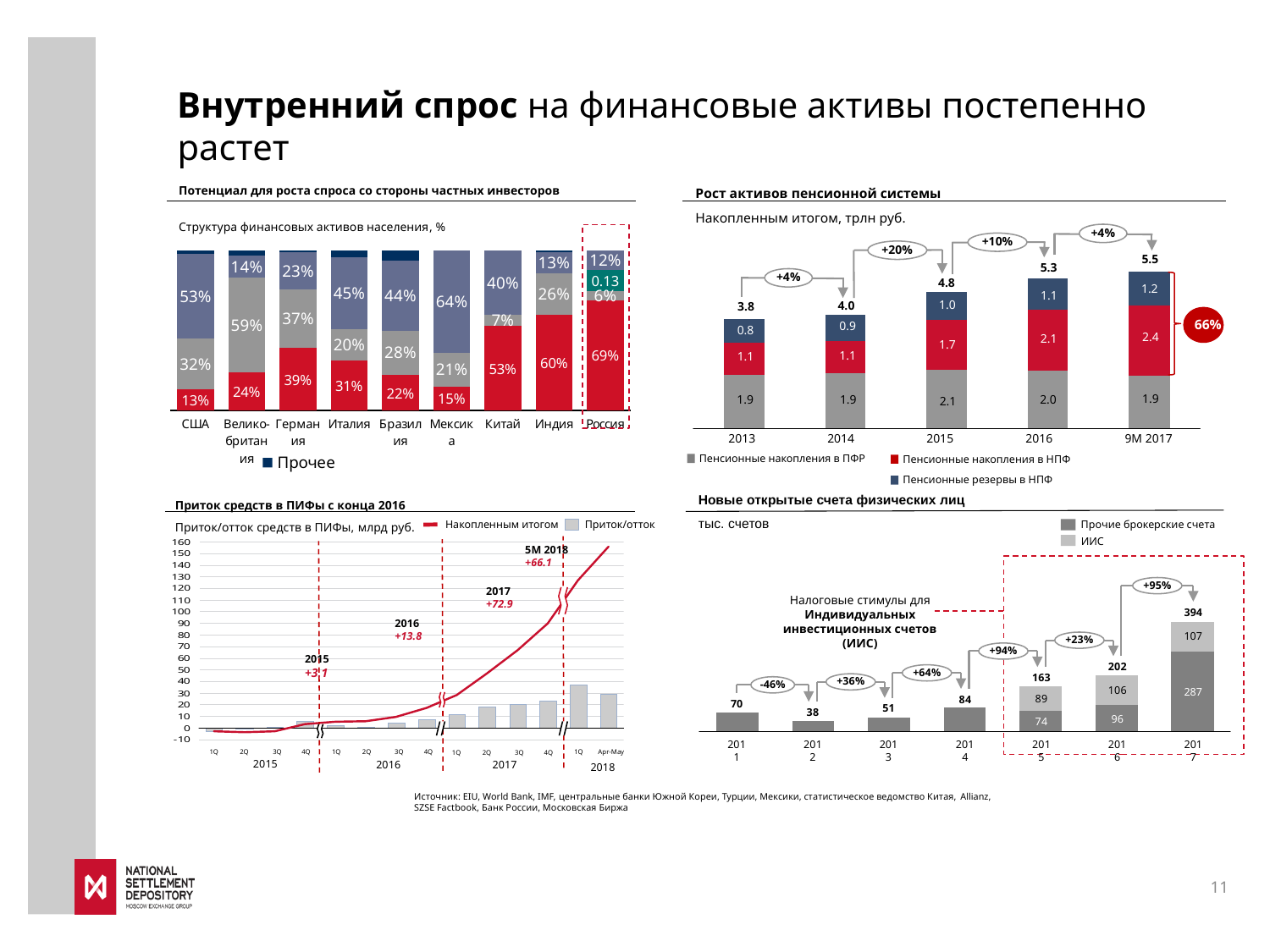
In the chart 'Потенциал для роста спроса со стороны частных инвесторов', how many countries are shown on the x axis? 9 In the chart 'Приток средств в ПИФы с конца 2016', which is larger, the annotated inflow for 2016 or for 5M 2018? 5M 2018 In the chart 'Приток средств в ПИФы с конца 2016', what is the annotated inflow for 2017? +72.9 In the chart 'Рост активов пенсионной системы', how many series does the legend list? 3 In the chart 'Рост активов пенсионной системы', what is the difference between the totals for 2015 and 2014? 0.8 In the chart 'Рост активов пенсионной системы', what is the value of 'Пенсионные накопления в НПФ' for 2016? 2.1 In the chart 'Рост активов пенсионной системы', what is the total value for 9M 2017? 5.5 In the chart 'Новые открытые счета физических лиц', what is the total number of accounts for 2017? 394 In the chart 'Новые открытые счета физических лиц', which year has the lowest value? 2012 In the chart 'Рост активов пенсионной системы', what percentage growth is shown between 2014 and 2015? +20% In the chart 'Новые открытые счета физических лиц', what is the value of 'ИИС' for 2016? 106 In the chart 'Новые открытые счета физических лиц', what percentage change is shown between 2016 and 2017? +95%